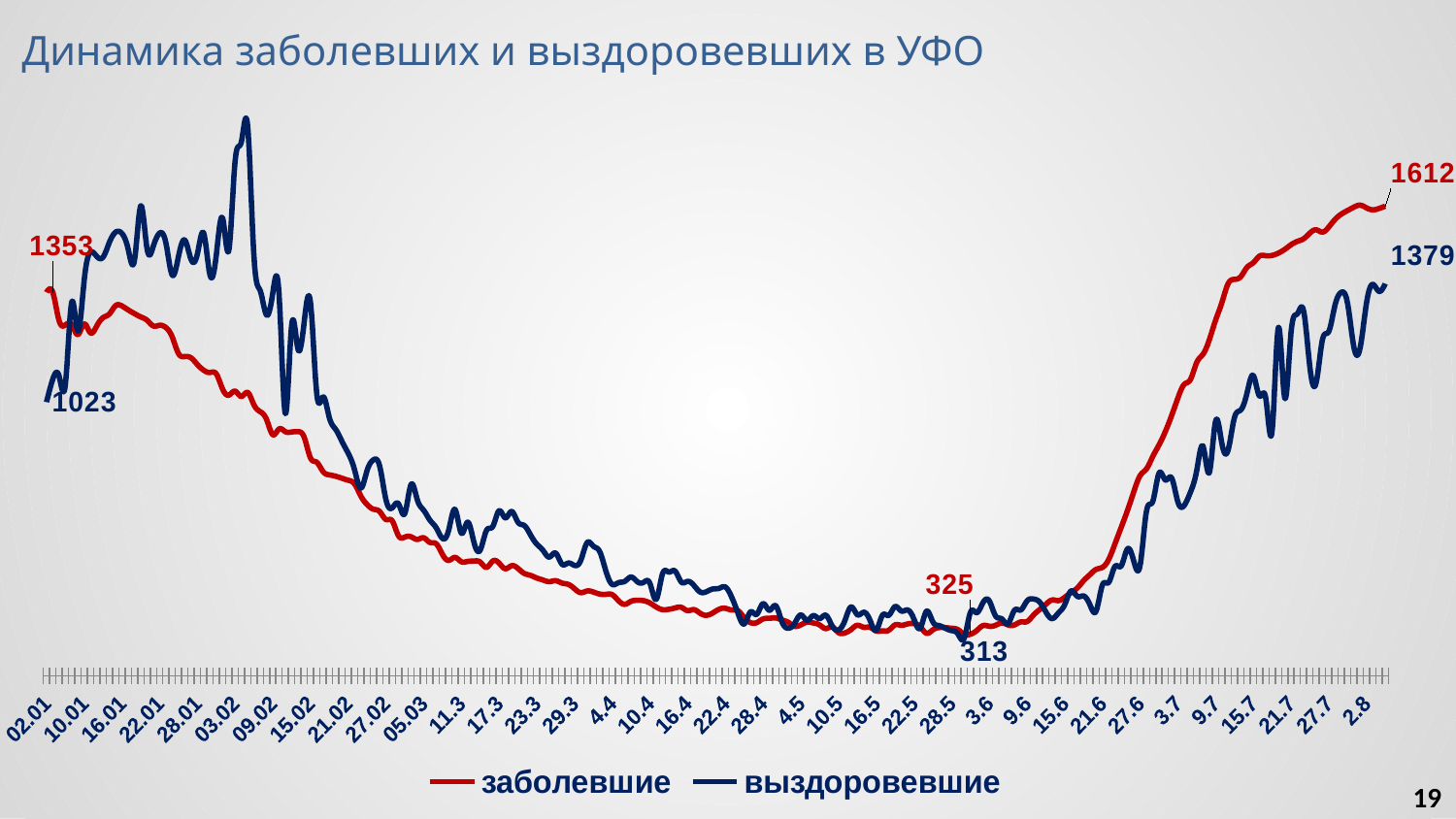
What kind of chart is shown on the slide? line chart What is the lowest labelled value of the выздоровевшие series? 313 At the end of the chart, which series has the higher labelled value, заболевшие or выздоровевшие? заболевшие Which series is drawn in red? заболевшие What is the lowest labelled value of the заболевшие series? 325 What is the last labelled value of the выздоровевшие series at the end of the chart? 1379 What is the title of the chart? Динамика заболевших и выздоровевших в УФО What is the last labelled value of the заболевшие series at the end of the chart? 1612 What is the difference between the final labelled values of заболевшие (1612) and выздоровевшие (1379)? 233 What is the first labelled value of the выздоровевшие series at the start of the chart? 1023 How many series does the legend list? 2 What is the first labelled value of the заболевшие series at the start of the chart? 1353